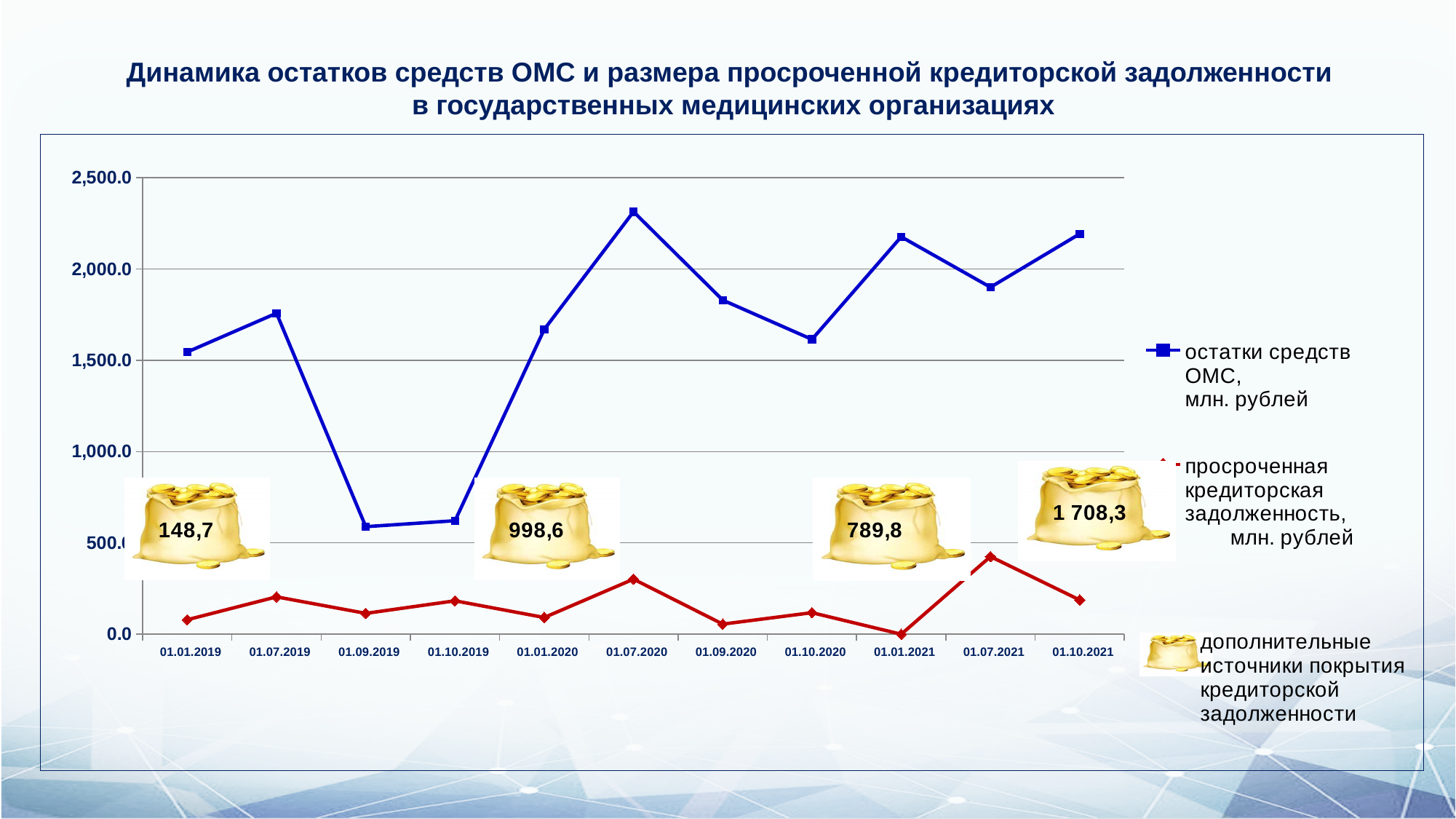
Which is larger for 'просроченная кредиторская задолженность': the value on 01.07.2020 or on 01.09.2020? 01.07.2020 How many lines are plotted on the chart? 2 How many dates are shown on the x axis of the chart? 11 On which date does the series 'просроченная кредиторская задолженность, млн. рублей' reach its highest value? 01.07.2021 Does the series 'остатки средств ОМС' rise or fall between 01.07.2019 and 01.09.2019? fall Is the value of 'остатки средств ОМС' on 01.09.2019 greater or less than 1,000.0? less On which date does the series 'просроченная кредиторская задолженность, млн. рублей' reach its lowest value? 01.01.2021 What amount is written on the money bag annotation placed near 01.10.2021? 1 708,3 What kind of chart is shown on the slide? line chart On which date does the series 'остатки средств ОМС, млн. рублей' reach its highest value? 01.07.2020 Is the value of 'просроченная кредиторская задолженность' on 01.07.2021 greater or less than 500.0? less Is the value of 'остатки средств ОМС' on 01.07.2020 greater or less than 2,000.0? greater